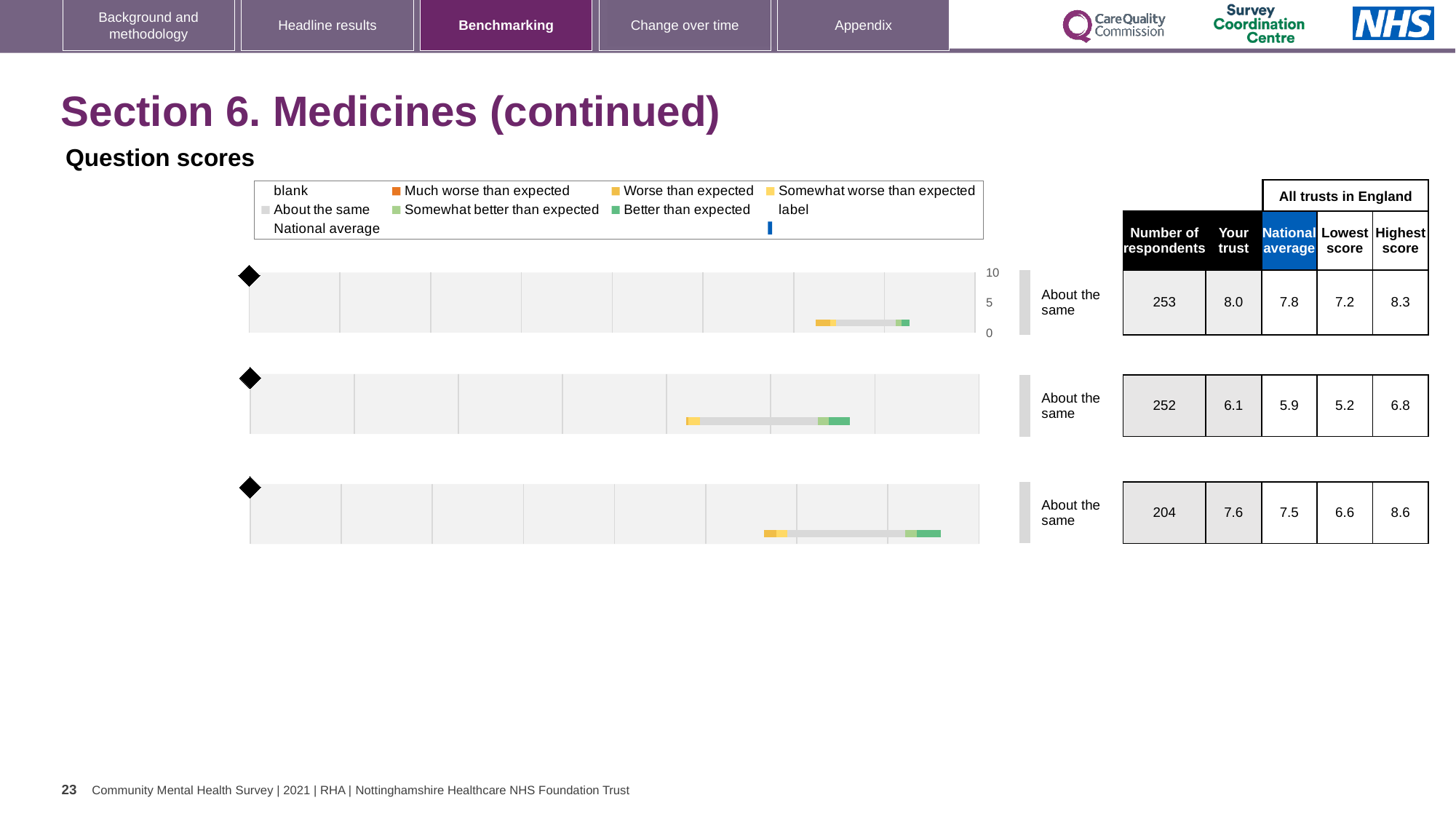
Which chart's row has the highest 'Highest score' value: top, middle or bottom? bottom For the middle chart's row, is the 'Your trust' score larger or smaller than the national average? larger How many benchmarking charts are shown on the slide? 3 For the bottom chart's row, what is the difference between the highest score and the lowest score? 2.0 In the table row for the middle chart, what is the national average? 5.9 For the top chart's row, what is the difference between the 'Your trust' score and the national average? 0.2 In the table row for the top chart, what is the 'Your trust' score? 8.0 What kind of chart is used for the three benchmarking charts on this slide? bar chart What benchmark category label is shown to the right of the top chart? About the same Which chart's row has the lowest 'Your trust' score: top, middle or bottom? middle What is the highest value shown on the vertical axis of the top chart? 10 In the table row for the bottom chart, what is the number of respondents? 204